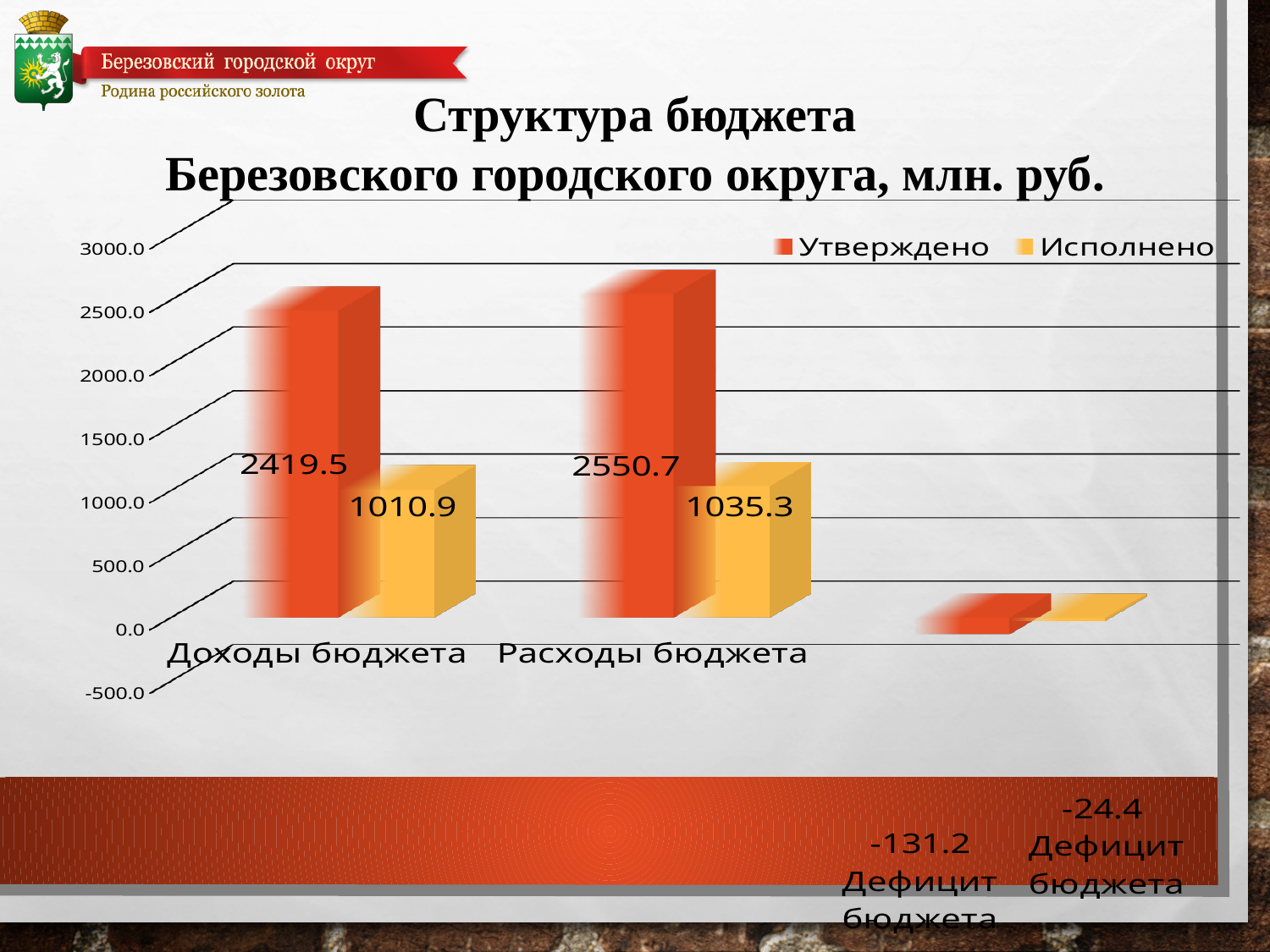
What is the difference between the Утверждено values for Расходы бюджета and Доходы бюджета? 131.2 What is the Исполнено value for Дефицит бюджета? -24.4 How many series does the legend list? 2 Which category has the lowest Исполнено value? Дефицит бюджета What kind of chart is shown on the slide? Bar chart Which category has the highest Утверждено value? Расходы бюджета What is the Утверждено value for Дефицит бюджета? -131.2 What is the Исполнено value for Расходы бюджета? 1035.3 Which is larger: the Исполнено value for Доходы бюджета or for Расходы бюджета? Расходы бюджета What is the Исполнено value for Доходы бюджета? 1010.9 What colour are the Исполнено bars? Yellow What is the Утверждено value for Доходы бюджета? 2419.5